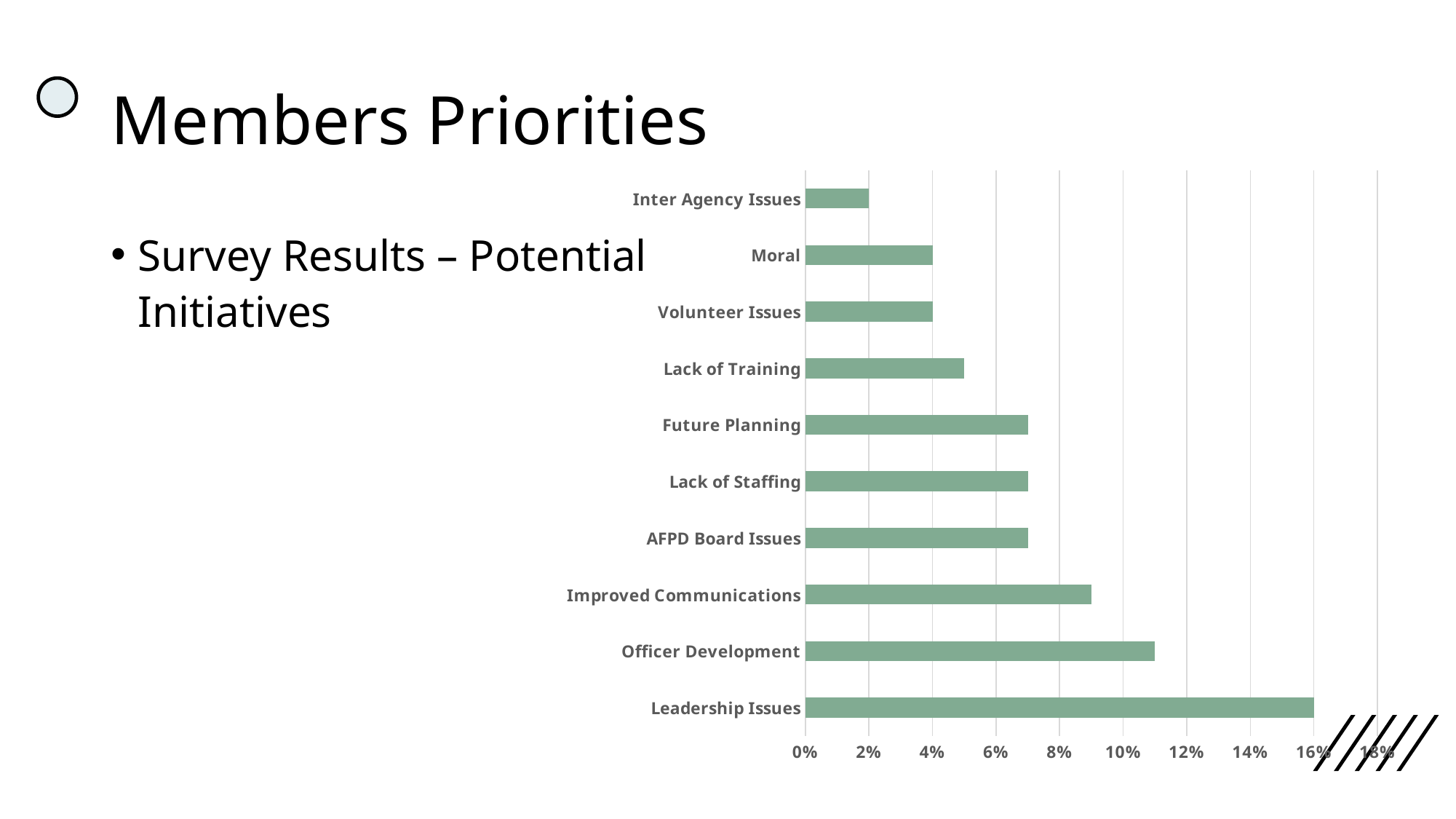
Which is larger, the value for Officer Development or the value for Improved Communications? Officer Development What kind of chart is shown on the slide? bar chart Which category has the highest value in the chart? Leadership Issues What is the value for Moral? 4% What is the value for Leadership Issues? 16% What is the difference between the values for Leadership Issues and Inter Agency Issues? 14% Is the value for Lack of Training greater or less than 6%? less What is the highest value shown on the horizontal axis? 18% How many categories are plotted in the chart? 10 Which category has the lowest value in the chart? Inter Agency Issues What is the value for Inter Agency Issues? 2% Is the value for Officer Development greater or less than 10%? greater